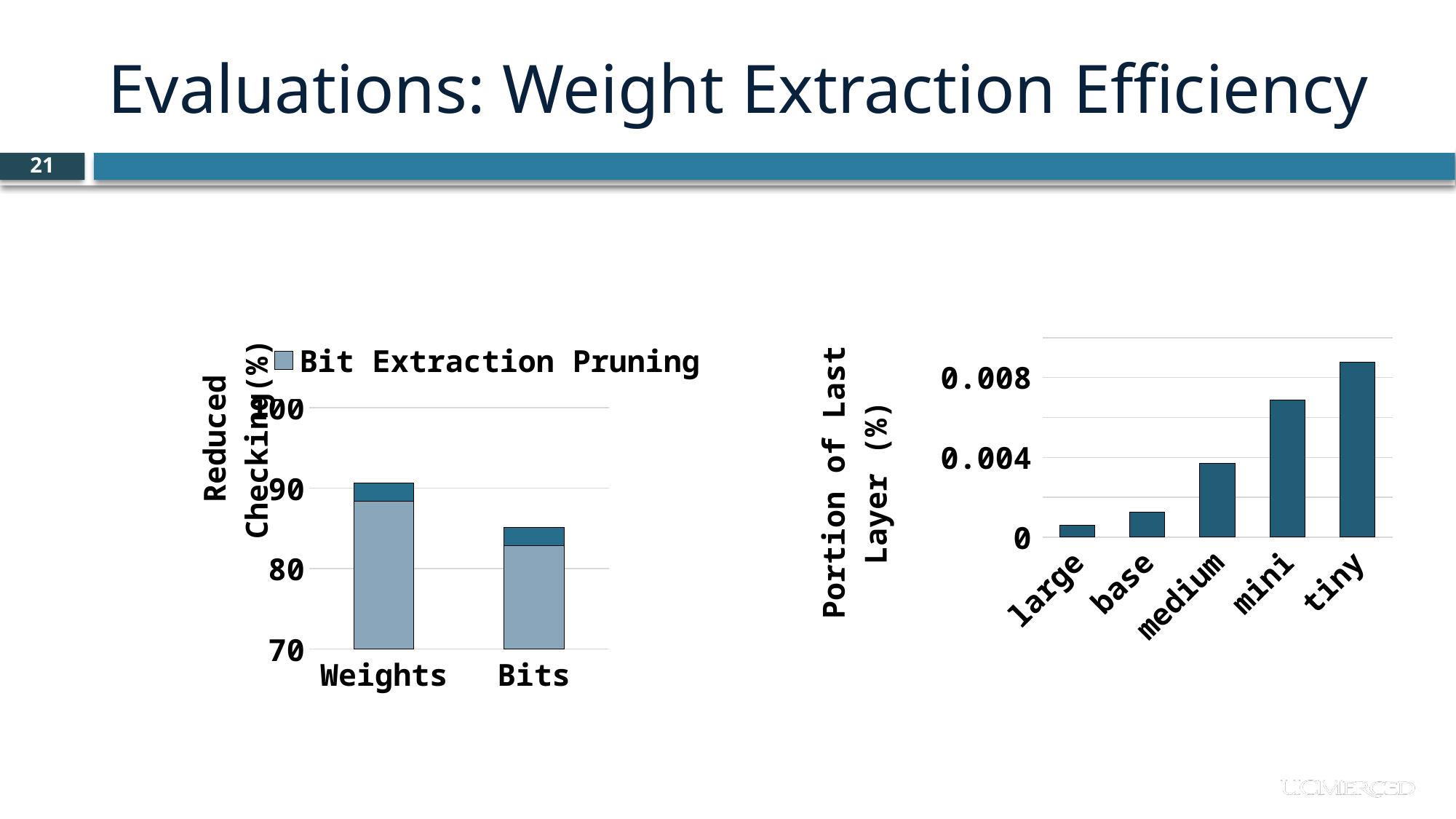
How many categories are shown on the x axis of the right chart (Portion of Last Layer)? 5 In the right chart (Portion of Last Layer), which category has the lowest value? large What is the legend entry shown on the left chart (Reduced Checking)? Bit Extraction Pruning How many categories are shown on the x axis of the left chart (Reduced Checking)? 2 In the right chart (Portion of Last Layer), is the value for tiny greater or less than 0.008? greater What kind of chart is the right chart (Portion of Last Layer)? bar chart What kind of chart is the left chart (Reduced Checking)? bar chart In the right chart (Portion of Last Layer), which category has the highest value? tiny In the right chart (Portion of Last Layer), do the values rise or fall from left to right along the x axis? rise In the left chart (Reduced Checking), which category has the taller stacked bar, Weights or Bits? Weights In the left chart (Reduced Checking), is the total stacked bar for Weights greater or less than 90? greater